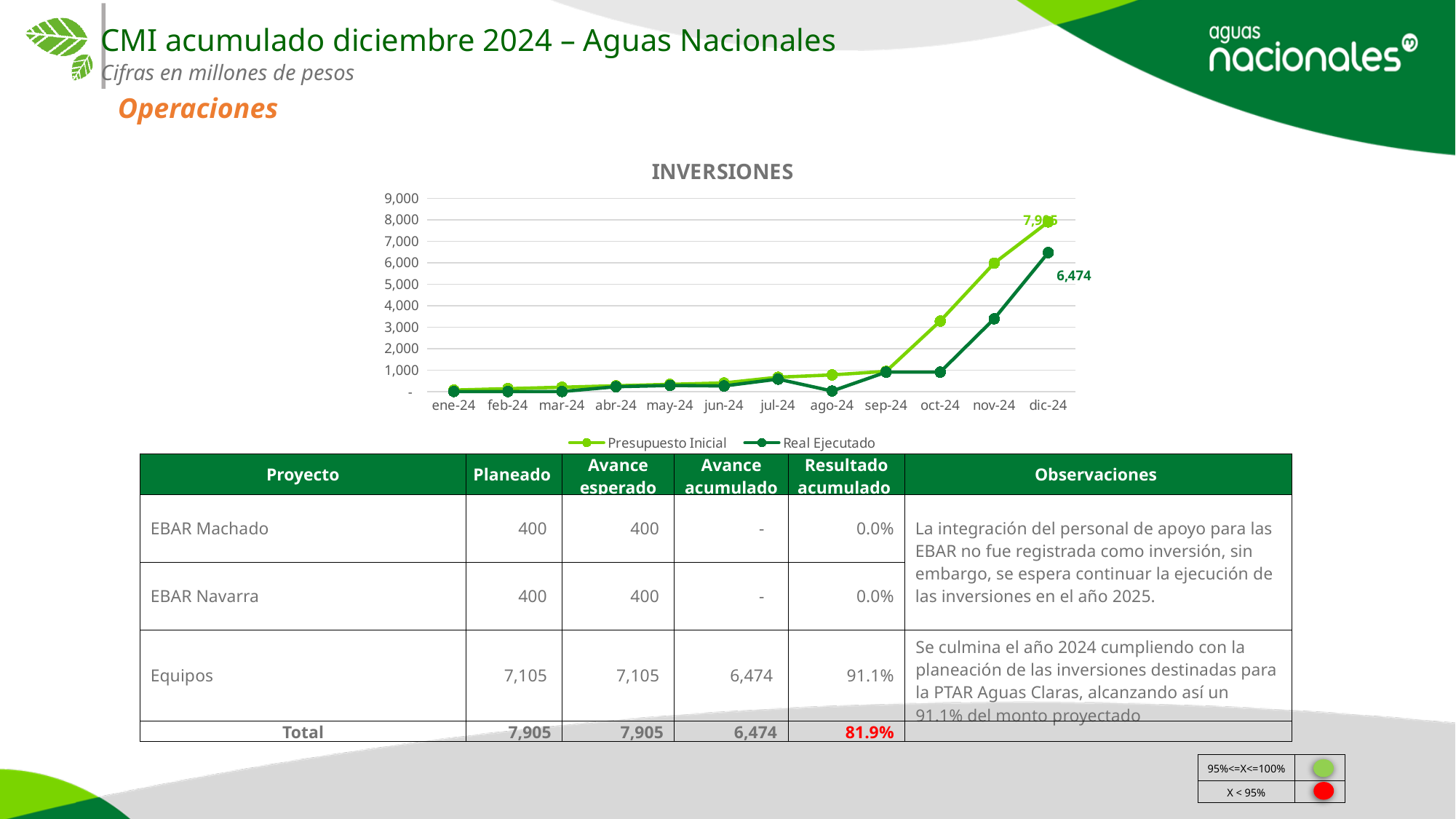
On the INVERSIONES chart, what is the difference between Presupuesto Inicial and Real Ejecutado in dic-24? 1,431 On the INVERSIONES chart, which series has the larger value in dic-24, Presupuesto Inicial or Real Ejecutado? Presupuesto Inicial How many months are shown on the x axis of the INVERSIONES chart? 12 On the INVERSIONES chart, is the Presupuesto Inicial value for nov-24 greater or less than 5,000? greater On the INVERSIONES chart, does the Real Ejecutado line rise or fall from sep-24 to dic-24? Rise What are the two legend entries of the INVERSIONES chart? Presupuesto Inicial and Real Ejecutado How many series does the legend of the INVERSIONES chart list? 2 What is the value of Presupuesto Inicial in dic-24 on the INVERSIONES chart? 7,905 What is the value of Real Ejecutado in dic-24 on the INVERSIONES chart? 6,474 What kind of chart is the INVERSIONES chart? Line chart On the INVERSIONES chart, is the Real Ejecutado value for nov-24 greater or less than 4,000? less In which month does Presupuesto Inicial reach its highest value on the INVERSIONES chart? dic-24